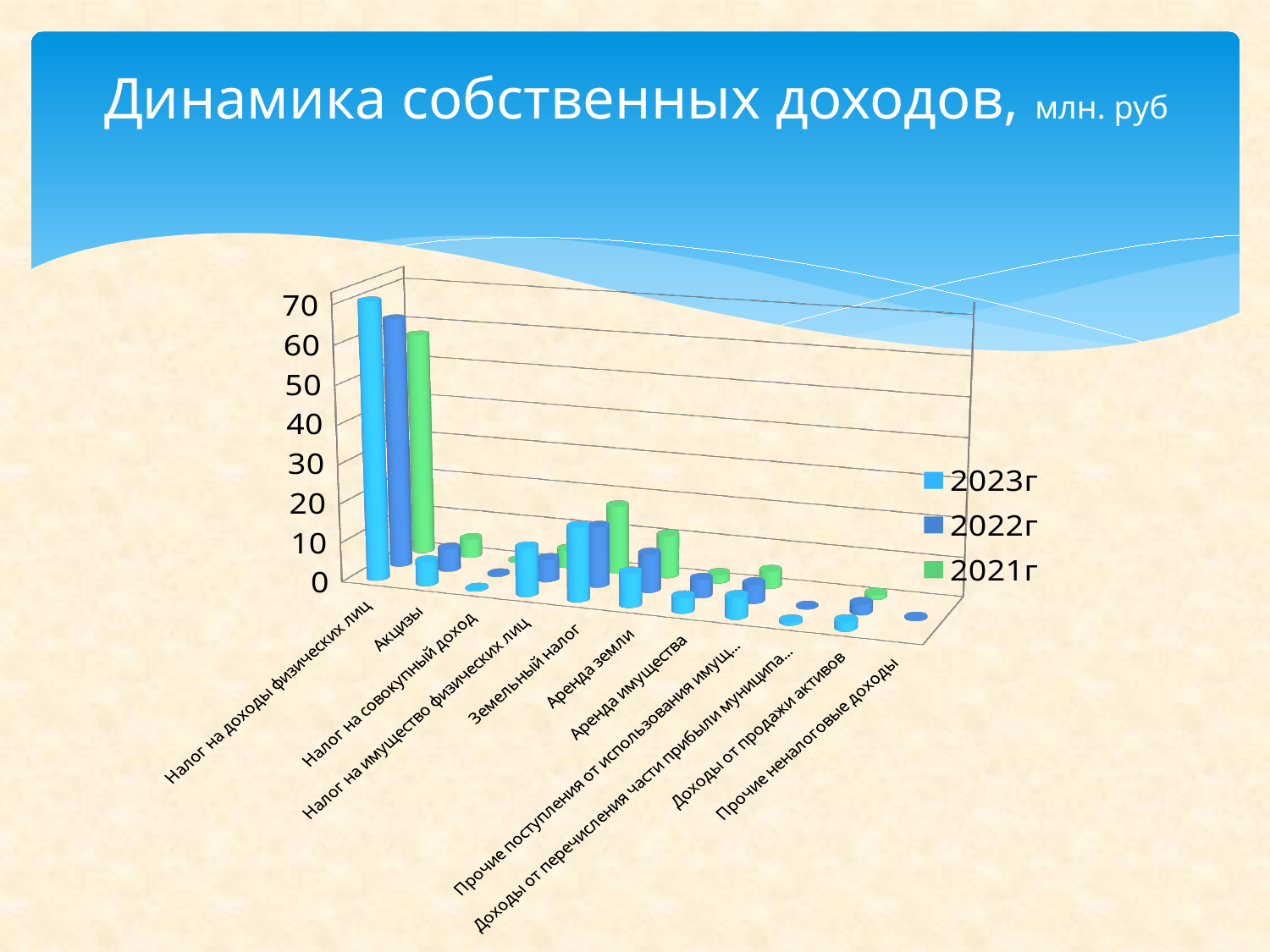
How many series does the legend list? 3 How many categories are shown on the x axis? 11 Is the 2021г value for Налог на доходы физических лиц greater or less than 40? greater Is the 2023г value for Акцизы greater or less than 20? less Is the 2023г value for Налог на доходы физических лиц greater or less than 50? greater Which series is shown in green in the legend? 2021г Which is larger for 2021г: Земельный налог or Акцизы? Земельный налог Which is larger for 2023г: Налог на доходы физических лиц or Земельный налог? Налог на доходы физических лиц Which category has the highest values across all series? Налог на доходы физических лиц What is the title of the chart? Динамика собственных доходов, млн. руб What kind of chart is shown on the slide? bar chart